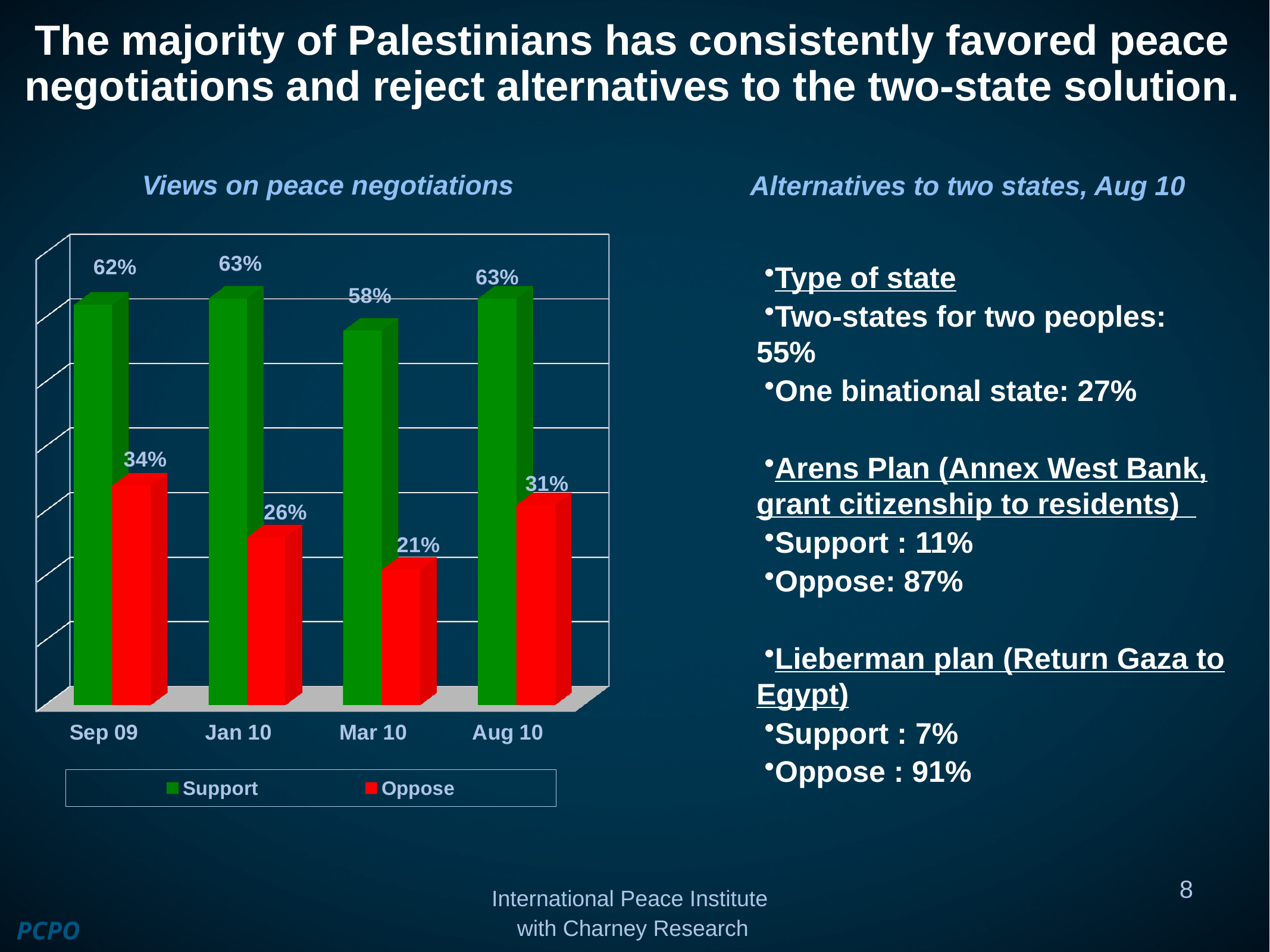
What is the Support value for Sep 09? 62% In which period is the Oppose value highest? Sep 09 What is the Oppose value for Mar 10? 21% What is the Support value for Mar 10? 58% What kind of chart is shown under "Views on peace negotiations"? Bar chart In which period is the Oppose value lowest? Mar 10 How many series does the chart's legend list? 2 What is the difference between the Support and Oppose values for Jan 10? 37% What is the Oppose value for Aug 10? 31% How many time periods are shown on the x axis of the chart? 4 In which period is the Support value lowest? Mar 10 Which is larger, the Oppose value for Sep 09 or the Oppose value for Aug 10? Sep 09